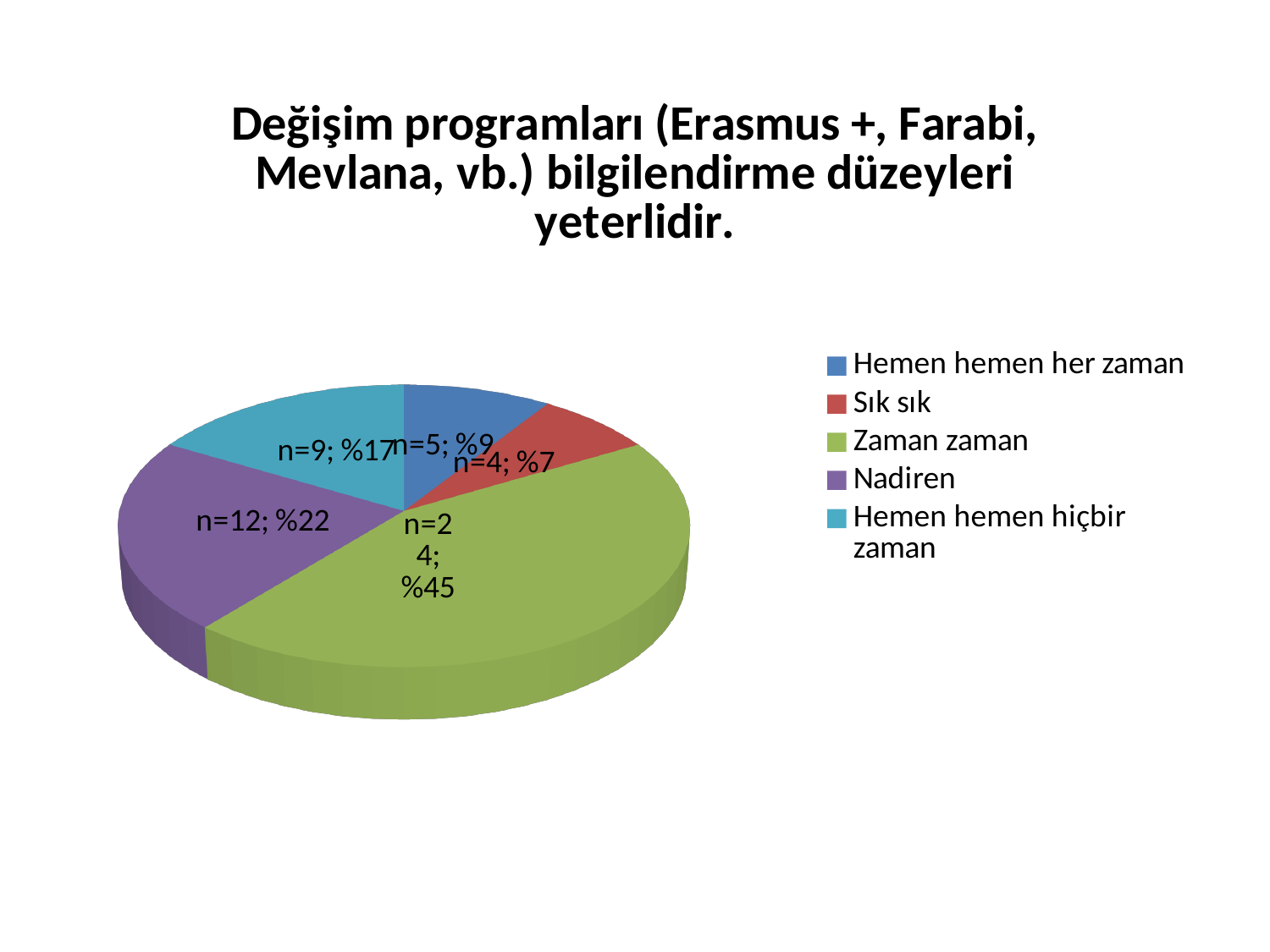
What is the count (n) for the 'Nadiren' slice? n=12 What percentage share does the 'Zaman zaman' slice have? %45 What percentage share does the 'Hemen hemen hiçbir zaman' slice have? %17 What percentage share does the 'Hemen hemen her zaman' slice have? %9 Which is larger, the 'Nadiren' slice or the 'Hemen hemen her zaman' slice? Nadiren What kind of chart is shown on the slide? pie chart What is the count (n) for the 'Sık sık' slice? n=4 How many categories does the legend list? 5 What is the count (n) for the 'Zaman zaman' slice? n=24 Which category has the largest slice? Zaman zaman Which category has the smallest slice? Sık sık What is the difference in count (n) between 'Nadiren' and 'Hemen hemen hiçbir zaman'? 3